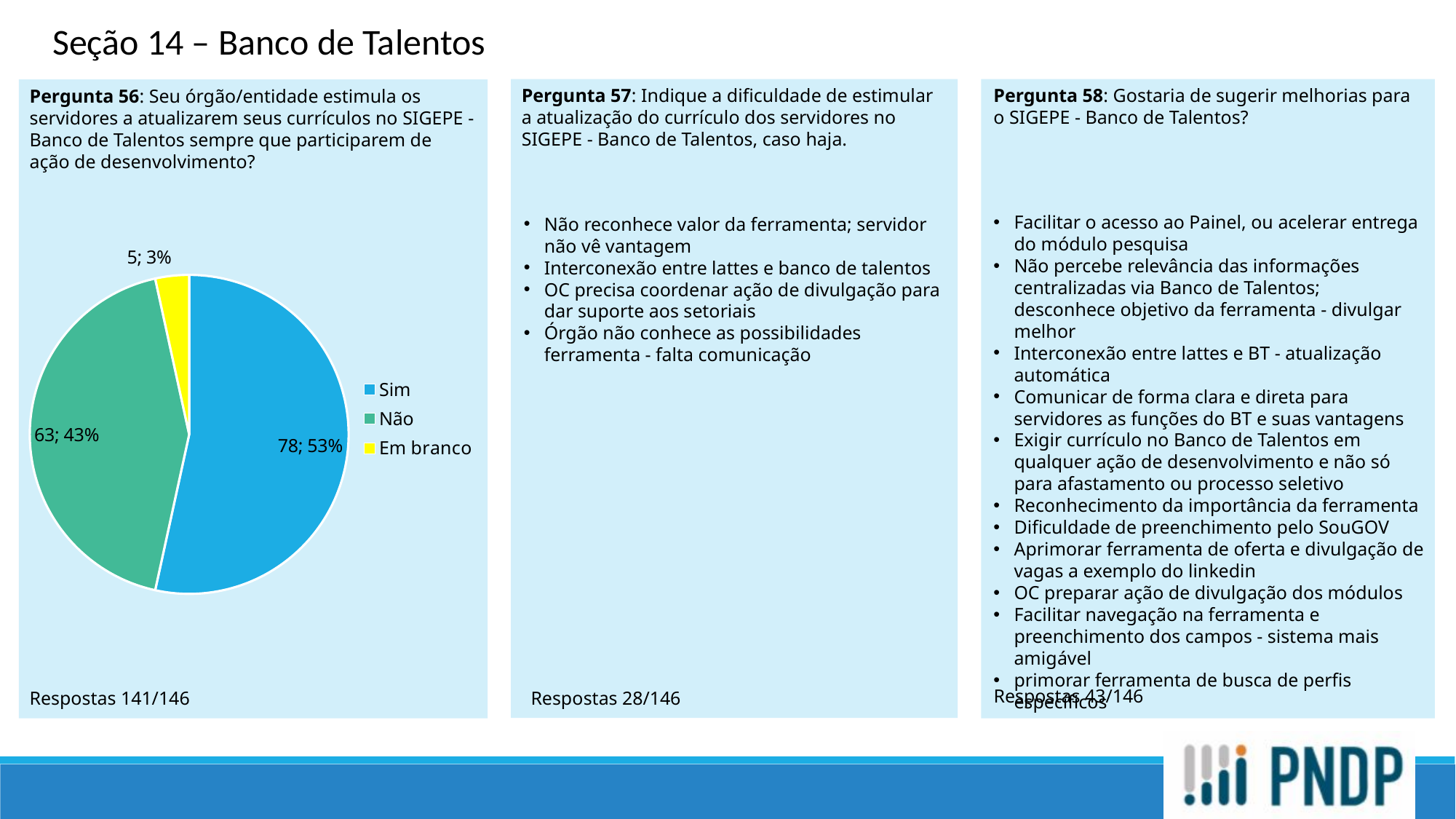
Which slice of the pie chart is the smallest? Em branco How many slices does the pie chart under Pergunta 56 have? 3 What percentage share of the pie chart does 'Não' represent? 43% Which colour represents 'Em branco' in the pie chart? yellow What is the count shown for the 'Sim' slice of the pie chart? 78 What percentage share of the pie chart does 'Sim' represent? 53% What is the difference between the counts for 'Sim' and 'Não' in the pie chart? 15 What kind of chart is shown under Pergunta 56? pie chart What is the count shown for the 'Não' slice of the pie chart? 63 Which slice of the pie chart is the largest? Sim What is the count shown for the 'Em branco' slice of the pie chart? 5 How many entries does the legend of the pie chart list? 3